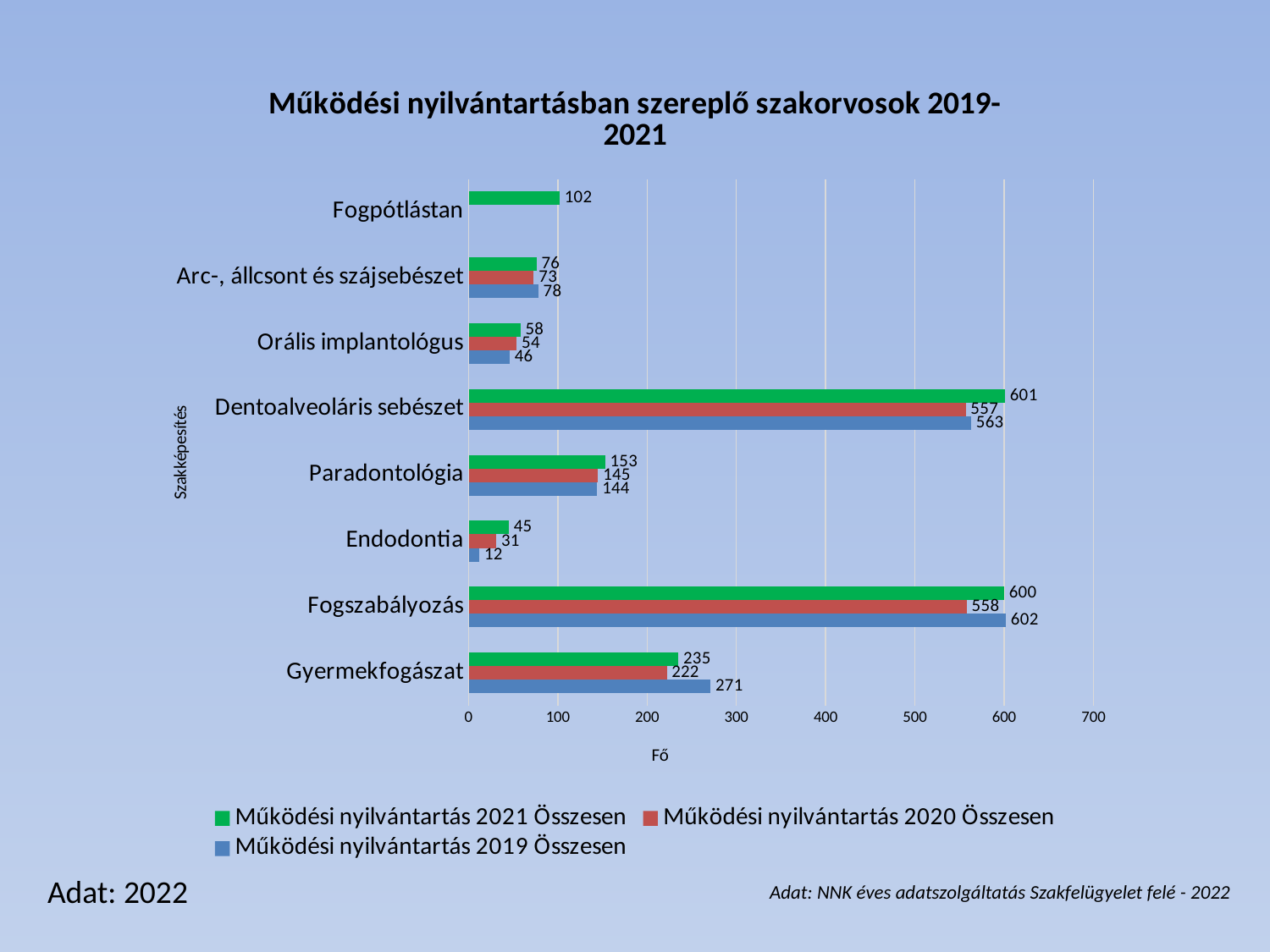
What is the difference between the 2019 and 2021 values for Gyermekfogászat? 36 Is the value for Fogszabályozás in the Működési nyilvántartás 2020 Összesen series greater or less than 500? greater How many series does the legend list? 3 In the Működési nyilvántartás 2021 Összesen series, which is larger: Paradontológia or Orális implantológus? Paradontológia What is the value for Endodontia in the Működési nyilvántartás 2019 Összesen series? 12 How many categories are shown on the y axis of the chart? 8 What is the title of the x axis? Fő Which category has the highest value in the Működési nyilvántartás 2019 Összesen series? Fogszabályozás Which category has the lowest value in the Működési nyilvántartás 2021 Összesen series? Endodontia What kind of chart is shown on the slide? bar chart What is the value for Dentoalveoláris sebészet in the Működési nyilvántartás 2020 Összesen series? 557 What is the value for Gyermekfogászat in the Működési nyilvántartás 2021 Összesen series? 235